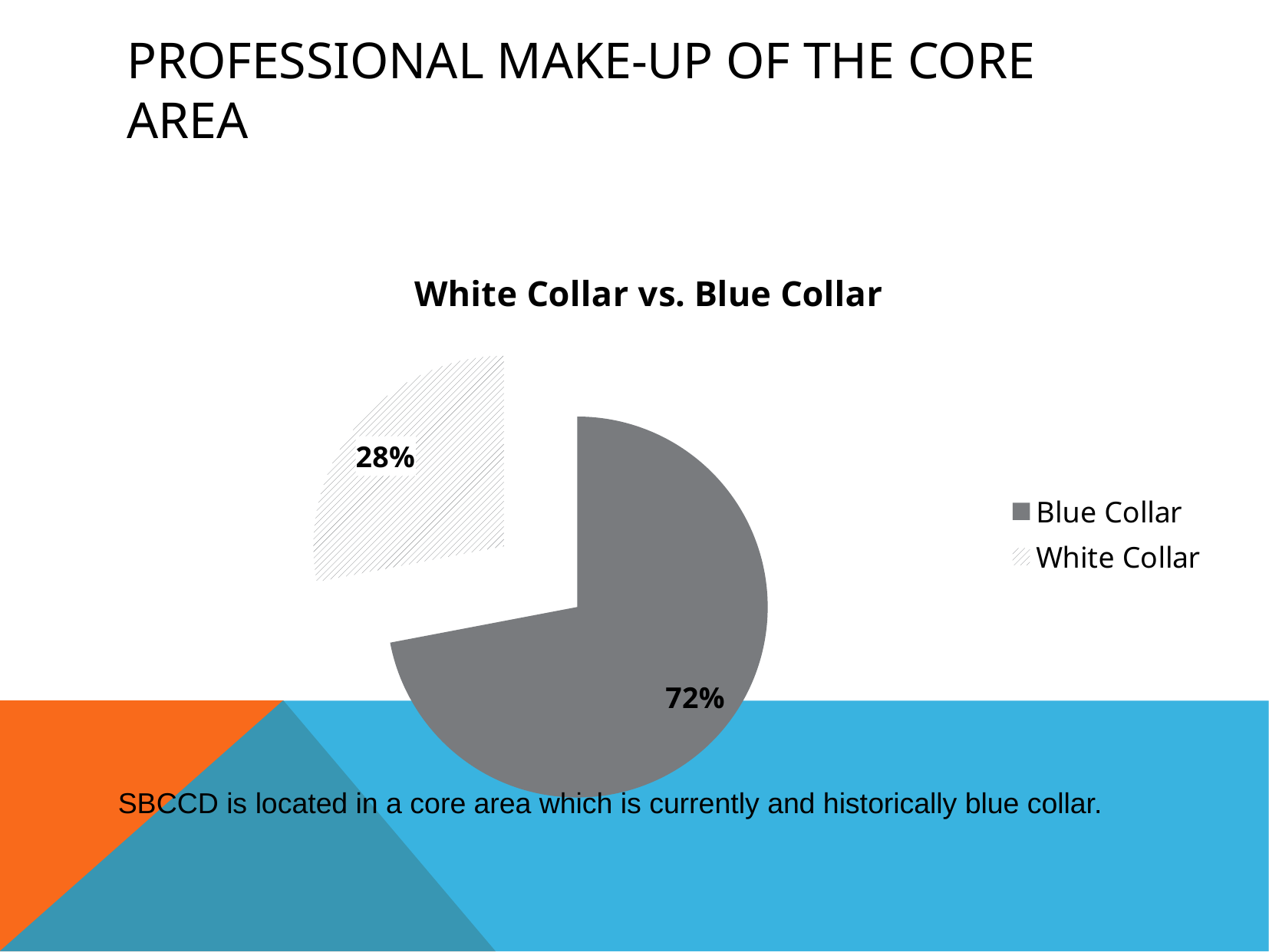
What percentage of the pie chart is White Collar? 28% What kind of chart is shown on the slide? Pie chart How many entries does the chart legend list? 2 Which category has the smallest share of the pie chart? White Collar What is the title of the chart? White Collar vs. Blue Collar What is the difference in percentage points between the Blue Collar and White Collar slices? 44 How many slices does the pie chart have? 2 Which slice of the pie chart is shown with a hatched pattern? White Collar Which category has the largest share of the pie chart? Blue Collar What percentage of the pie chart is Blue Collar? 72% Which is larger, the Blue Collar slice or the White Collar slice? Blue Collar